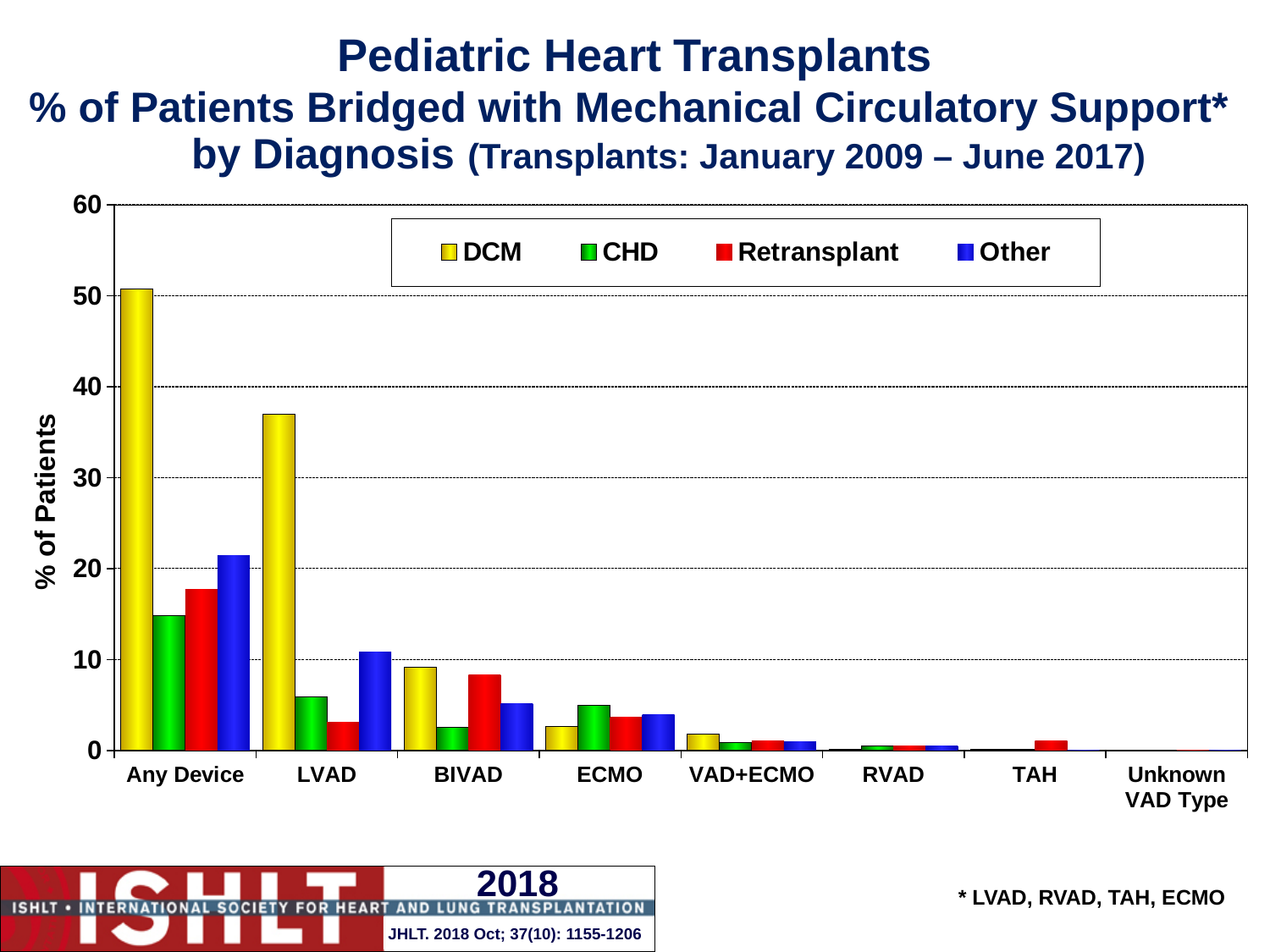
Which series has the lowest value for LVAD? Retransplant How many series does the legend list? 4 How many device categories are shown on the x axis? 8 Is the DCM value for Any Device greater or less than 40? greater Is the Other value for LVAD greater or less than 20? less For LVAD, which is larger: the DCM value or the CHD value? DCM What kind of chart is shown on the slide? bar chart For Any Device, which is larger: the Other value or the CHD value? Other For BIVAD, which is larger: the Retransplant value or the CHD value? Retransplant Which device category has the highest DCM value? Any Device What is the label on the y axis? % of Patients Is the DCM value for LVAD greater or less than 30? greater